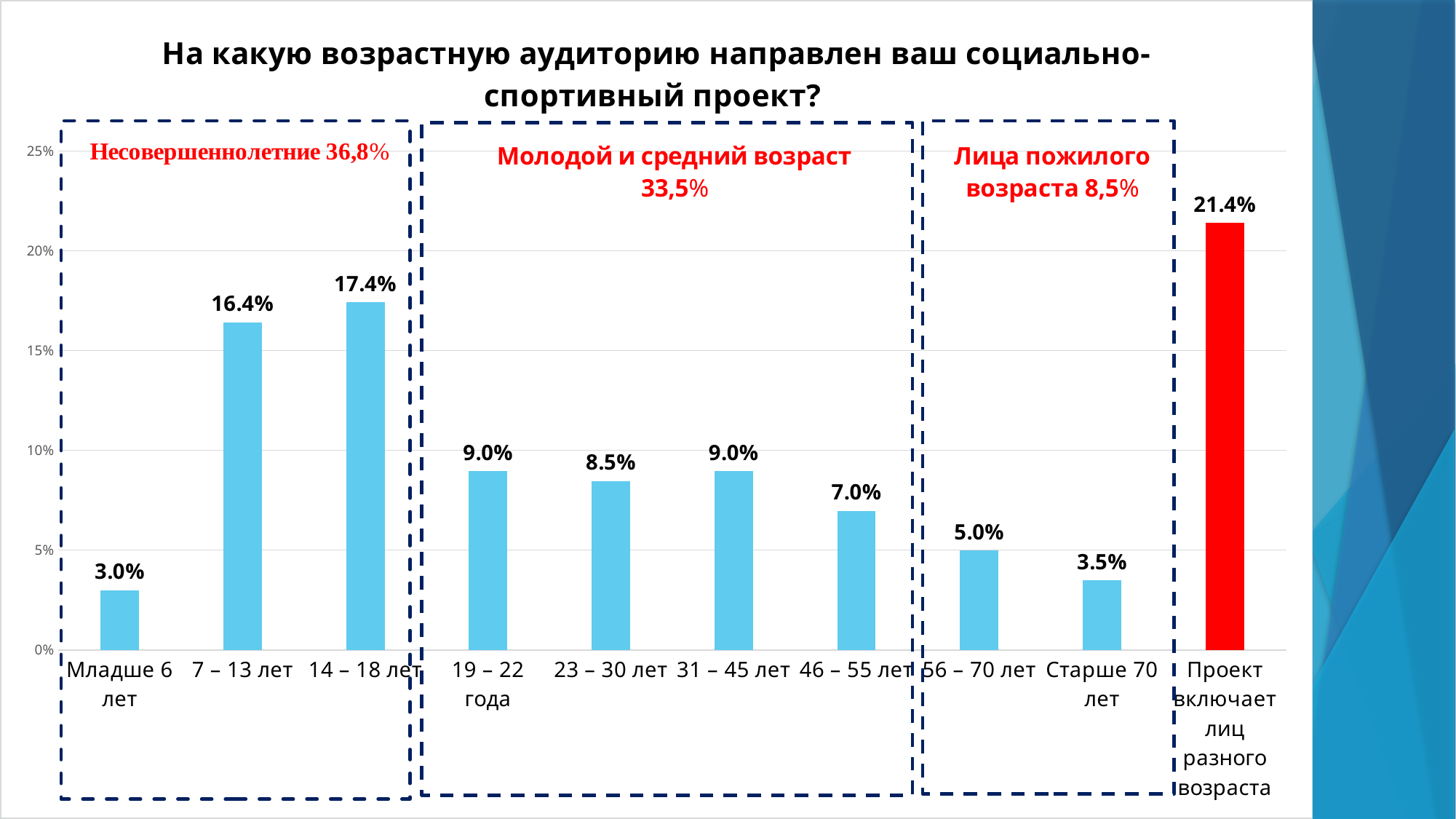
What is the difference between the values for "14 – 18 лет" and "7 – 13 лет"? 1.0% What value is shown for the "46 – 55 лет" category? 7.0% Which bar is coloured red rather than blue? Проект включает лиц разного возраста How many categories are shown on the x axis? 10 What percentage is given for the group labelled "Несовершеннолетние"? 36,8% Is the value for "14 – 18 лет" greater or less than 15%? greater What value is shown for the "7 – 13 лет" category? 16.4% What kind of chart is shown on the slide? Bar chart Which is larger, the value for "23 – 30 лет" or the value for "56 – 70 лет"? 23 – 30 лет Which category has the highest value? Проект включает лиц разного возраста Which category has the lowest value? Младше 6 лет What value is shown for the "Старше 70 лет" category? 3.5%